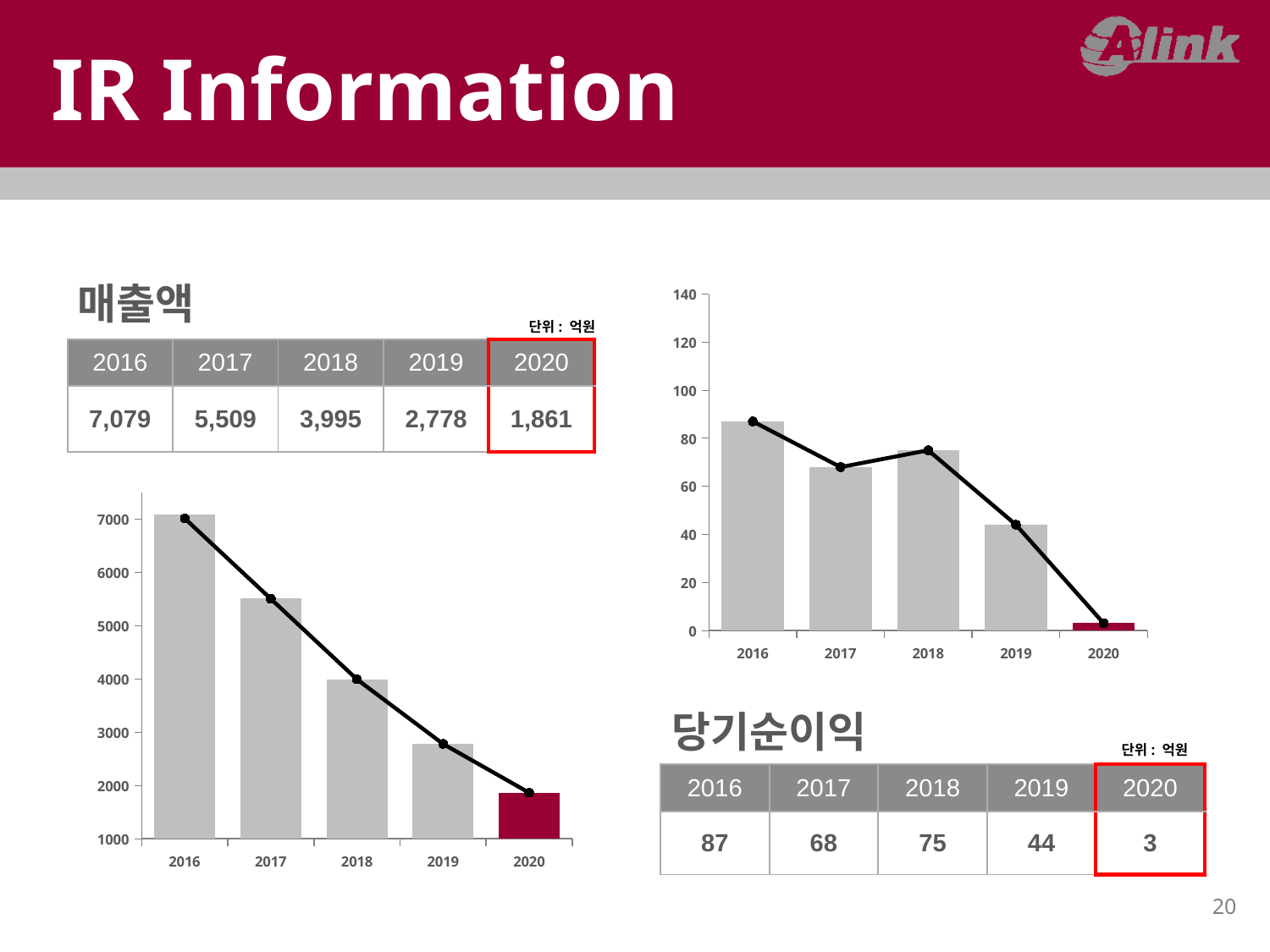
What unit is stated for the values on the 당기순이익 chart on the right? 억원 On the 당기순이익 chart on the right, what is the difference between the 2018 and 2019 values? 31 On the 매출액 chart on the left, what is the difference between the 2016 and 2017 values? 1,570 On the 당기순이익 chart on the right, which year has the lowest value? 2020 On the 매출액 chart on the left, what is the value for 2020? 1,861 On the 매출액 chart on the left, is the value for 2018 greater or less than 4000? less How many years are shown on the 매출액 chart on the left? 5 On the 매출액 chart on the left, what is the value for 2016? 7,079 On the 당기순이익 chart on the right, what is the value for 2018? 75 On the 당기순이익 chart on the right, which is larger, the value for 2017 or the value for 2018? 2018 Do the values on the 매출액 chart on the left rise or fall from 2016 to 2020? fall On the 당기순이익 chart on the right, which year has the highest value? 2016